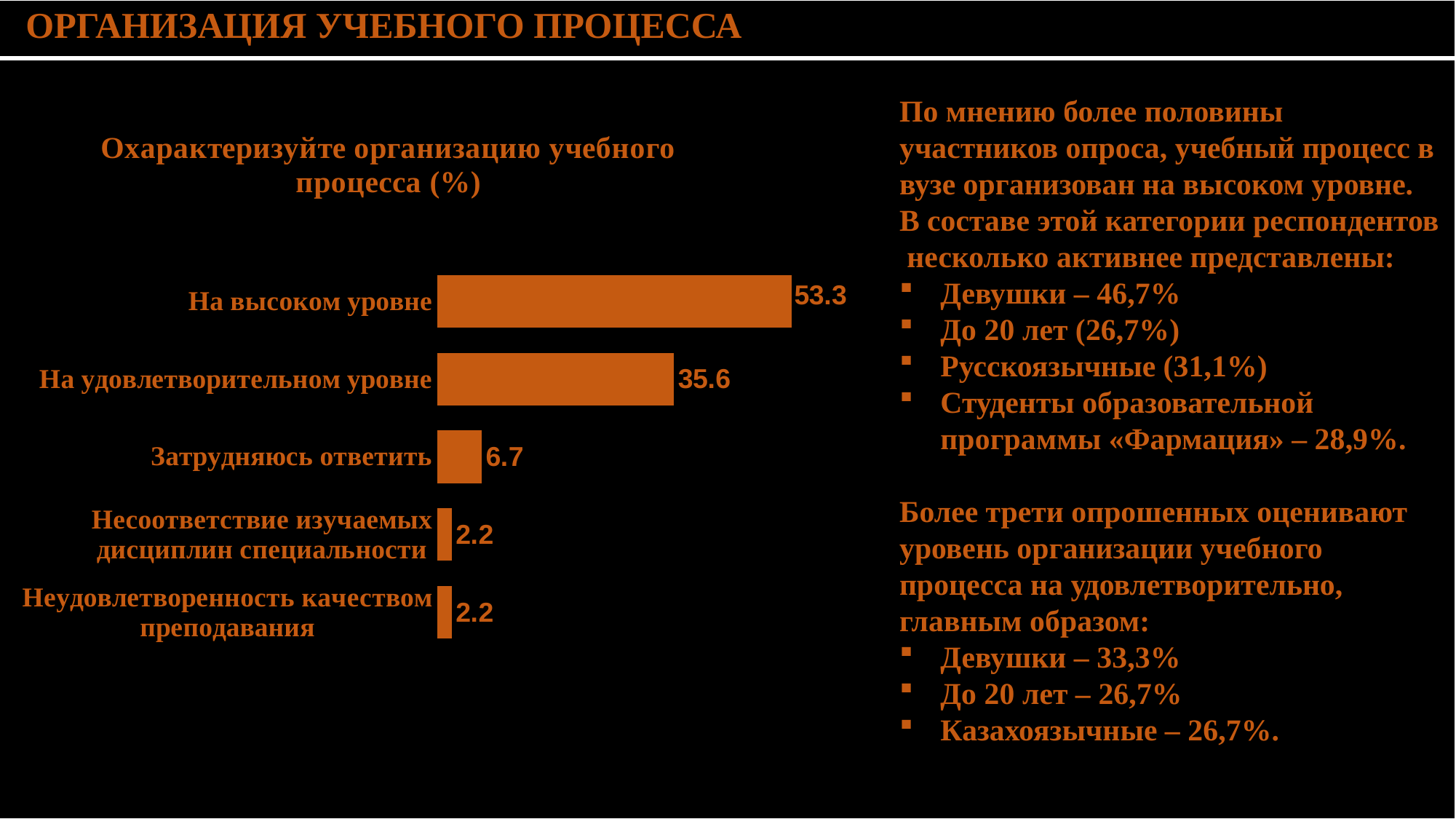
What is the value for 'Несоответствие изучаемых дисциплин специальности'? 2.2 Which is larger, the value for 'Затрудняюсь ответить' or the value for 'Неудовлетворенность качеством преподавания'? Затрудняюсь ответить What is the difference between the values for 'На удовлетворительном уровне' and 'Затрудняюсь ответить'? 28.9 What is the value for 'На высоком уровне'? 53.3 What is the value for 'На удовлетворительном уровне'? 35.6 Which category has the highest value? На высоком уровне What kind of chart is shown on the slide? Bar chart What is the difference between the values for 'На высоком уровне' and 'На удовлетворительном уровне'? 17.7 How many categories are shown in the chart? 5 What is the value for 'Затрудняюсь ответить'? 6.7 What colour are the bars in the chart? Orange What is the title of the chart? Охарактеризуйте организацию учебного процесса (%)